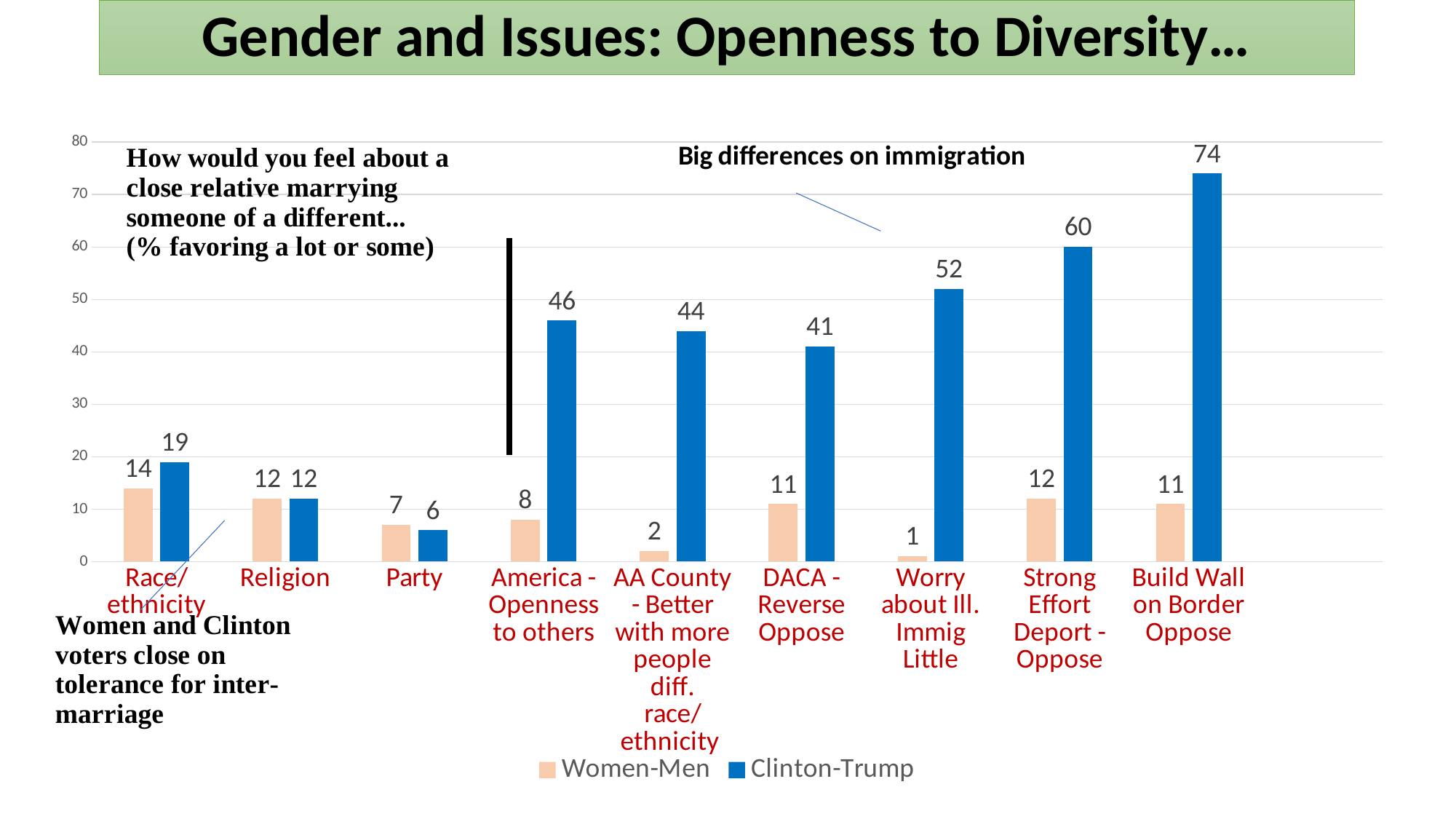
What is the difference between the Clinton-Trump and Women-Men values for Strong Effort Deport - Oppose? 48 Which category has the lowest Women-Men value? Worry about Ill. Immig Little What is the Women-Men value for Race/ethnicity? 14 Which category has the highest Clinton-Trump value? Build Wall on Border Oppose What kind of chart is shown on the slide? Bar chart Which is larger for Party: the Women-Men value or the Clinton-Trump value? Women-Men What is the Clinton-Trump value for DACA - Reverse Oppose? 41 What colour are the Clinton-Trump bars? Blue What is the Clinton-Trump value for Build Wall on Border Oppose? 74 What is the Women-Men value for Worry about Ill. Immig Little? 1 How many categories are shown on the x axis? 9 How many series does the legend list? 2